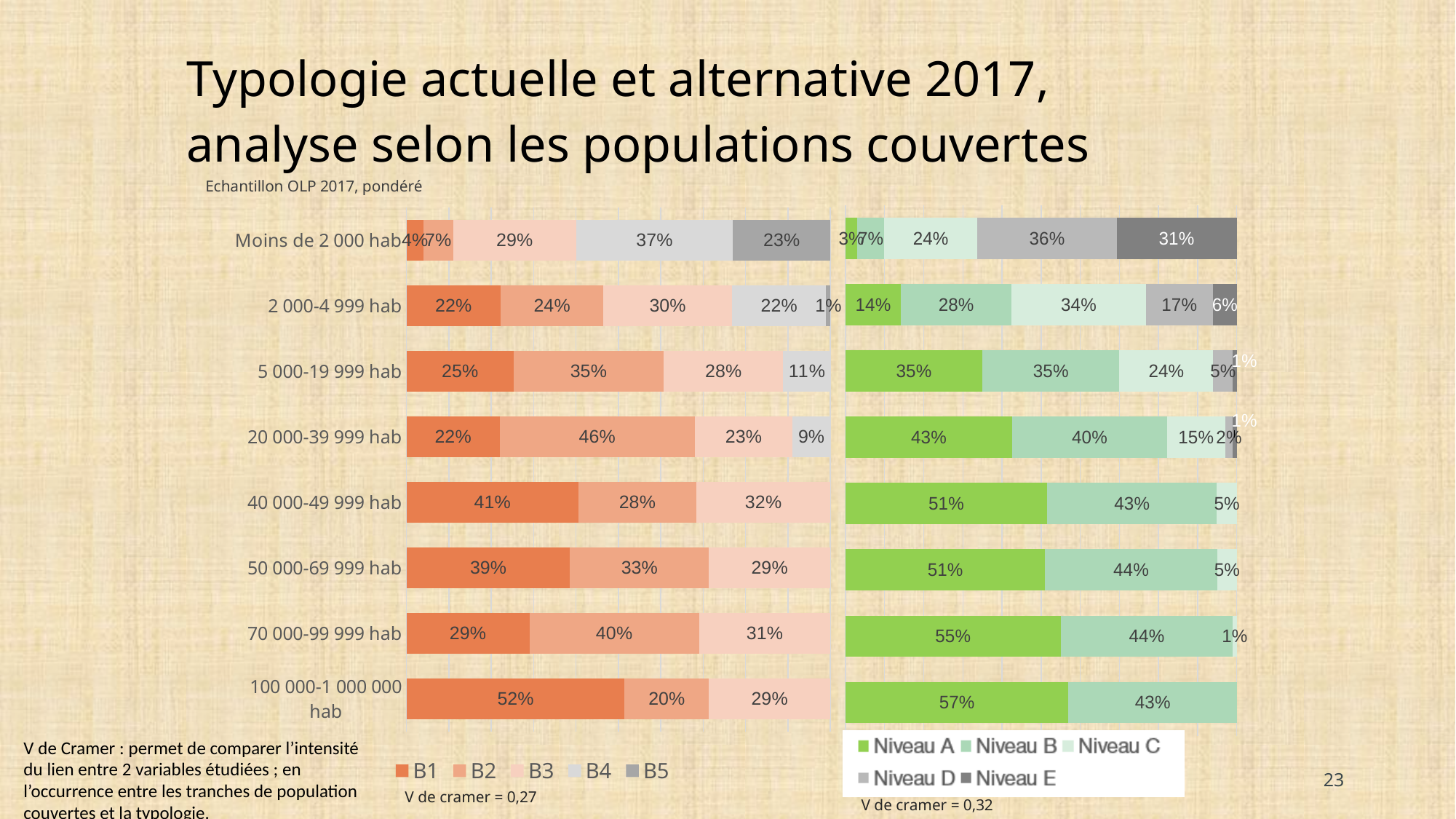
On the right chart, what is the Niveau E value for Moins de 2 000 hab? 31% On the right chart, what is the Niveau A value for 70 000-99 999 hab? 55% On the left chart, what is the B2 value for 20 000-39 999 hab? 46% How many series does the legend of the right chart list? 5 On the left chart, which category has the lowest B1 value? Moins de 2 000 hab On the right chart, which category has the highest Niveau A value? 100 000-1 000 000 hab What kind of chart is the left chart? Stacked bar chart How many population categories are shown on the left chart? 8 On the left chart, what is the difference between the B1 values for 40 000-49 999 hab and 50 000-69 999 hab? 2% On the right chart, which is larger for 2 000-4 999 hab: Niveau B or Niveau C? Niveau C On the left chart, what is the B1 value for 100 000-1 000 000 hab? 52% What V de Cramer value is shown under the right chart? 0,32